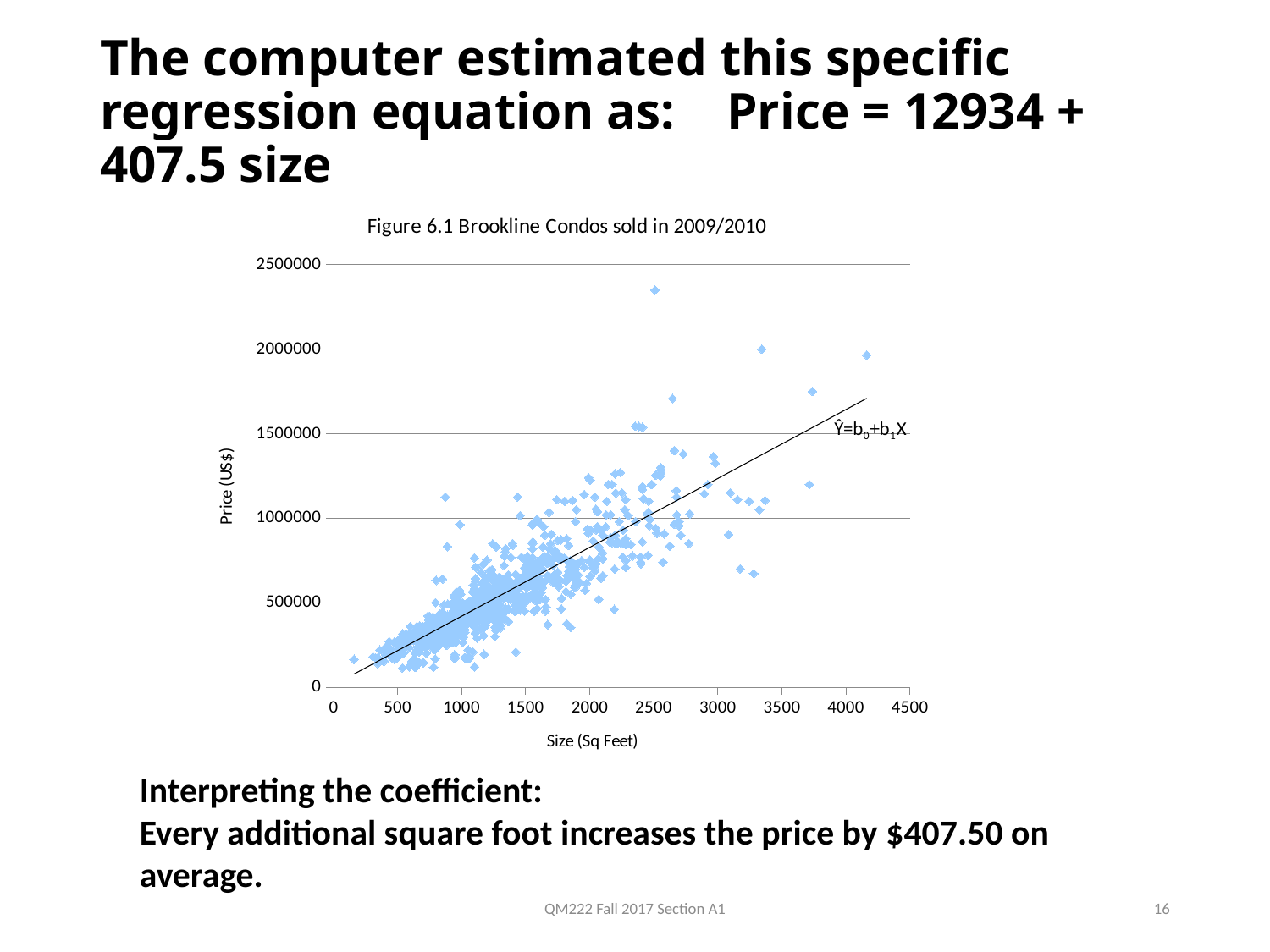
Is the price of the highest point on the chart greater or less than 2000000? greater Is the lowest price shown on the chart greater or less than 500000? less What label is written next to the fitted line on the chart? Ŷ=b0+b1X What kind of chart is shown on the slide? scatter plot Is the size of the highest-priced point greater or less than 2000 square feet? greater What is the highest value shown on the x axis? 4500 As size increases along the x axis, do prices generally rise or fall? rise What is the title of the chart? Figure 6.1 Brookline Condos sold in 2009/2010 What is the highest value shown on the y axis? 2500000